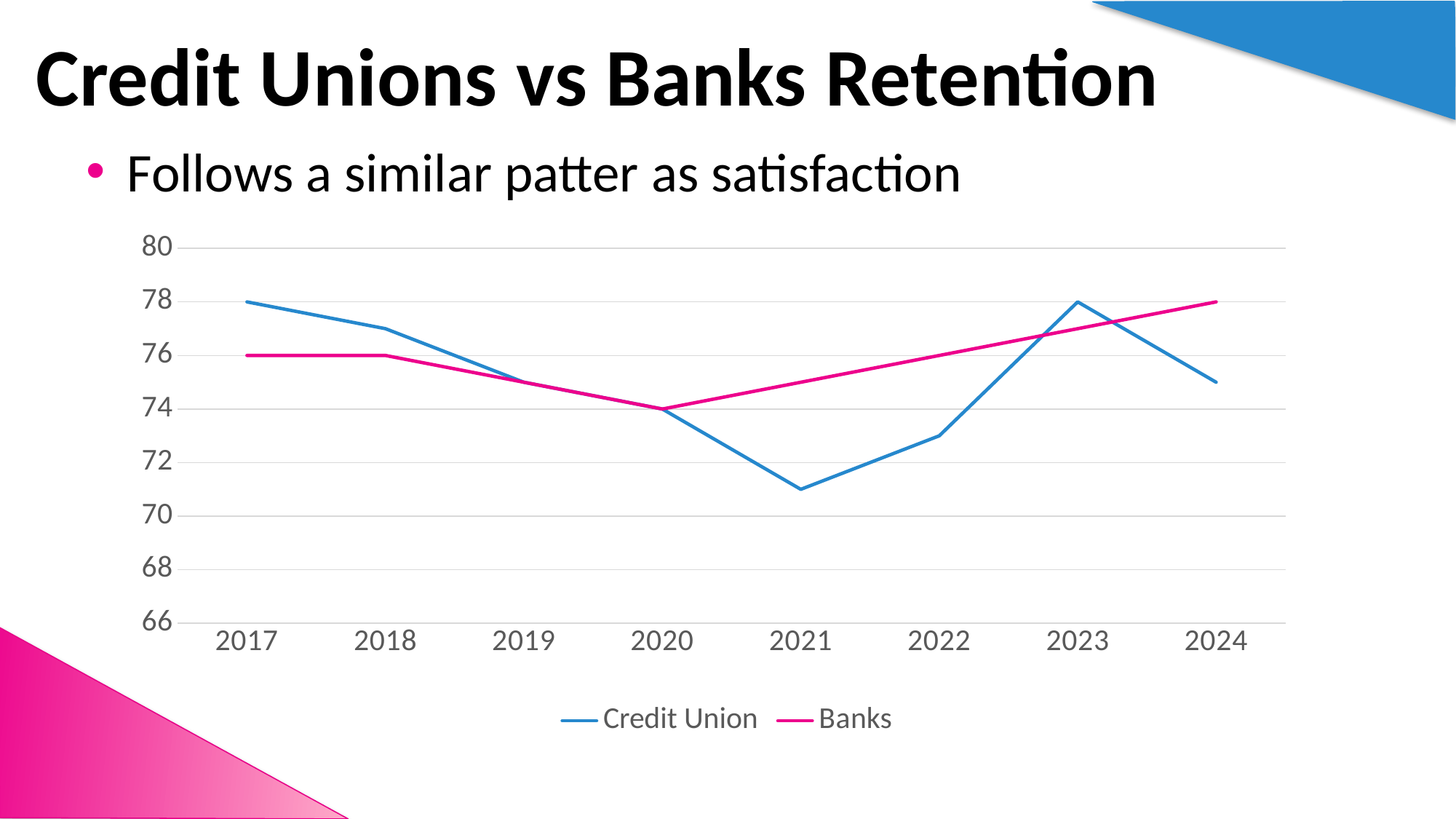
What type of chart is shown on the slide? Line chart What is the difference between the Banks value in 2024 and the Banks value in 2020? 4 Does the Banks line rise or fall from 2020 to 2024? Rises What is the Credit Union retention value in 2017? 78 Is the Credit Union value for 2021 greater or less than 72? less How many series does the legend list? 2 Which series has the larger value in 2023, Credit Union or Banks? Credit Union In which year is the Credit Union retention value lowest? 2021 In which year is the Banks retention value highest? 2024 What is the Banks retention value in 2024? 78 What is the Credit Union retention value in 2020? 74 How many years are shown on the x axis? 8